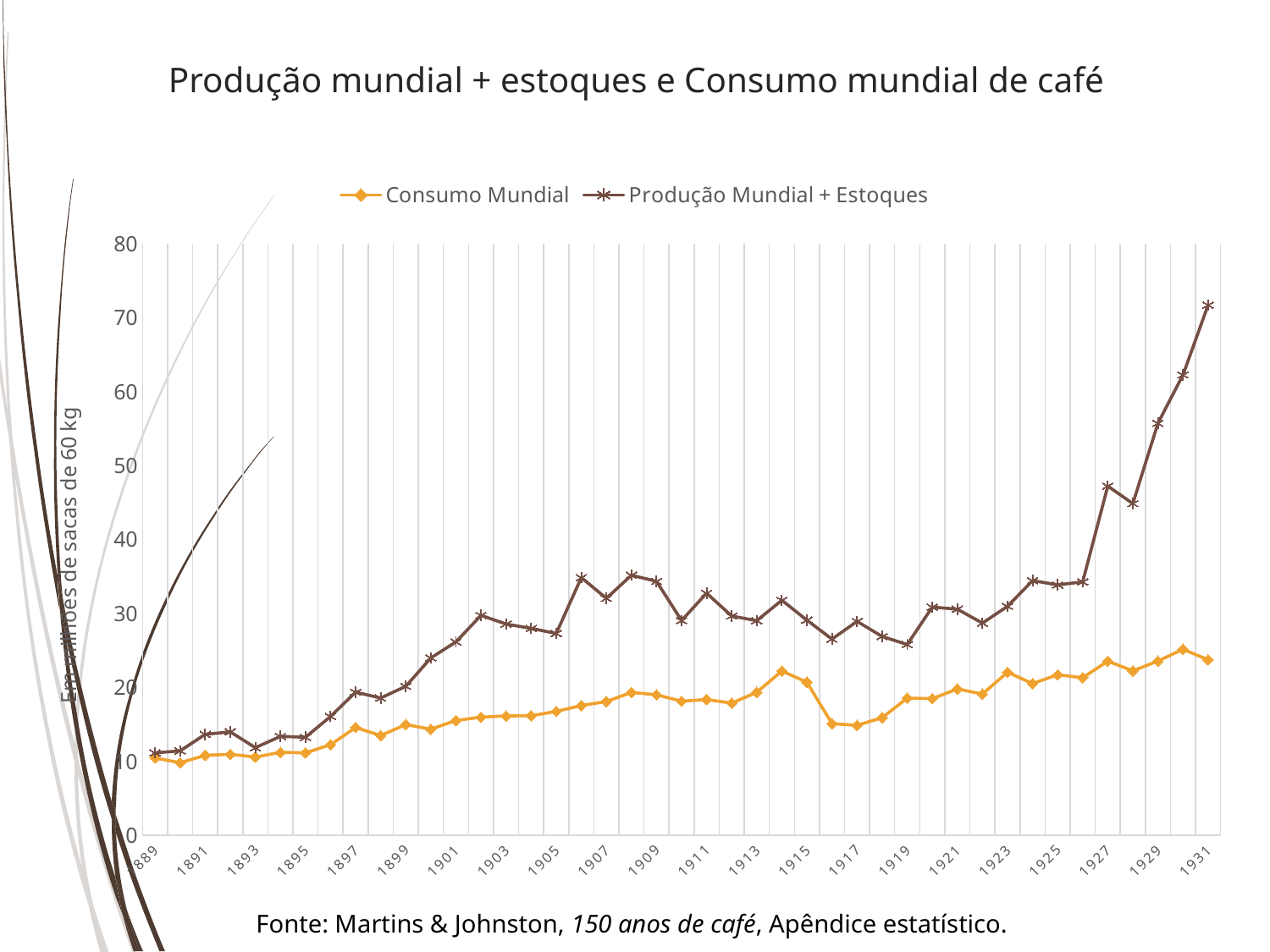
Which series is drawn with orange diamond markers? Consumo Mundial Is the value for Produção Mundial + Estoques in 1931 greater or less than 60? greater Is the value for Produção Mundial + Estoques in 1889 greater or less than 20? less In 1931, which series has the larger value, Consumo Mundial or Produção Mundial + Estoques? Produção Mundial + Estoques In which year does the Produção Mundial + Estoques series reach its highest value? 1931 Is the value for Consumo Mundial in 1917 greater or less than 20? less What is the title of the chart? Produção mundial + estoques e Consumo mundial de café Does the Produção Mundial + Estoques series rise or fall overall between 1927 and 1931? rise How many series does the legend list? 2 What kind of chart is shown on the slide? line chart